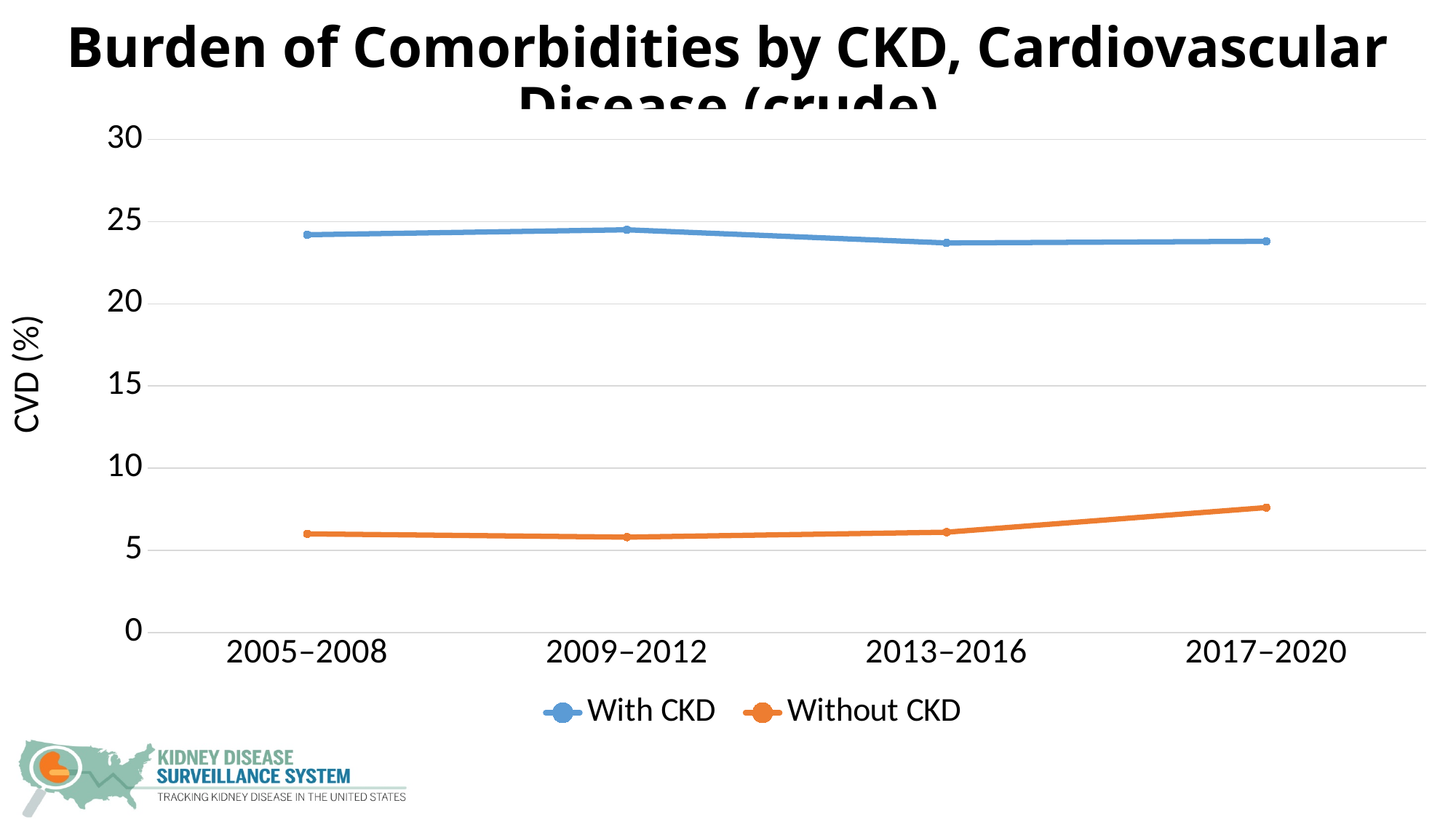
Does the Without CKD line rise or fall from 2013–2016 to 2017–2020? rise What kind of chart is shown on the slide? line chart Is the value for With CKD in 2009–2012 greater or less than 25? less How many series does the legend list? 2 In which period is the Without CKD value highest? 2017–2020 Is the value for With CKD in 2005–2008 greater or less than 20? greater Which series has the larger value in 2017–2020, With CKD or Without CKD? With CKD Is the value for Without CKD in 2005–2008 greater or less than 10? less What is the label on the y axis? CVD (%) How many time periods are shown on the x axis? 4 Does the With CKD line rise or fall from 2009–2012 to 2013–2016? fall